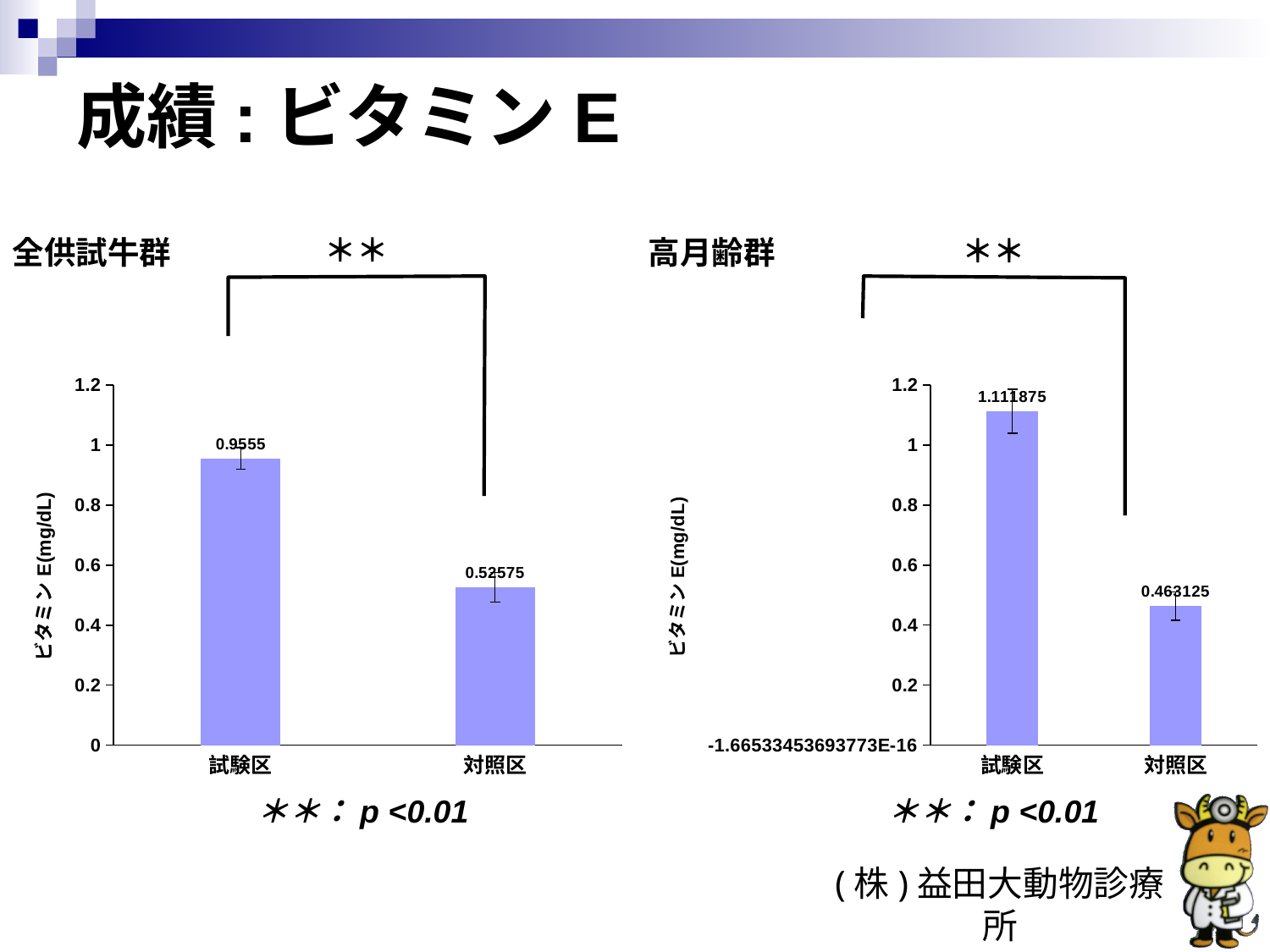
In the right chart (高月齢群), what is the difference between the values for 試験区 and 対照区? 0.64875 In the left chart (全供試牛群), what is the value for 対照区? 0.52575 In the right chart (高月齢群), what is the value for 試験区? 1.111875 In the left chart (全供試牛群), what is the difference between the values for 試験区 and 対照区? 0.42975 In the left chart (全供試牛群), which category has the higher value? 試験区 In the right chart (高月齢群), which category has the lowest value? 対照区 In the right chart (高月齢群), what is the value for 対照区? 0.463125 In the left chart (全供試牛群), what is the value for 試験区? 0.9555 In the right chart (高月齢群), is the value for 試験区 greater or less than 1? greater How many categories are shown in the left chart (全供試牛群)? 2 What is the y-axis label of the left chart (全供試牛群)? ビタミンE(mg/dL) What kind of chart is the right chart (高月齢群)? bar chart